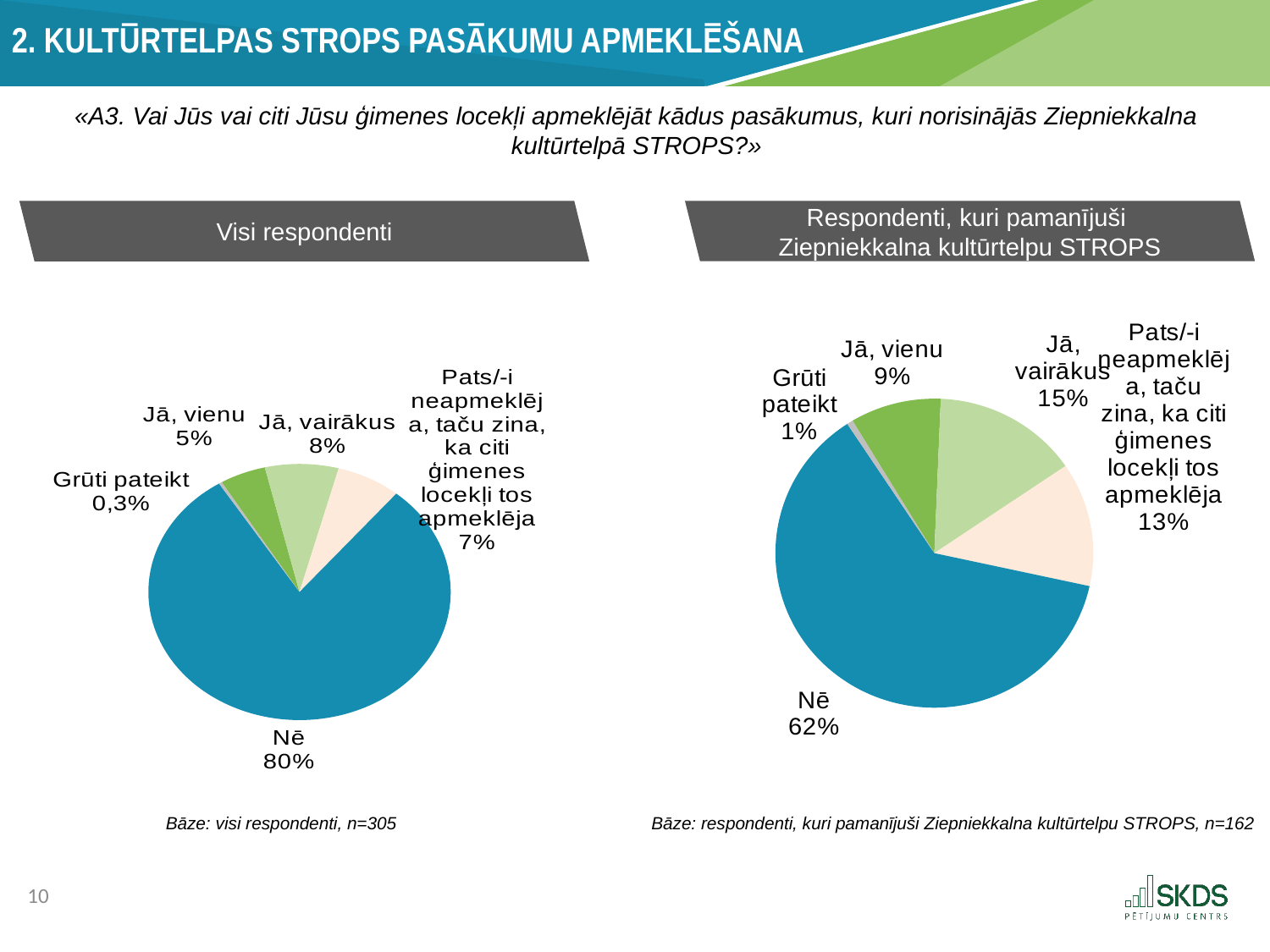
In the 'Visi respondenti' pie chart, what share of respondents answered 'Nē'? 80% In the 'Visi respondenti' pie chart, which category has the largest slice? Nē What is the difference between the 'Nē' share in the 'Visi respondenti' chart and the 'Nē' share in the 'Respondenti, kuri pamanījuši Ziepniekkalna kultūrtelpu STROPS' chart? 18 percentage points In the 'Visi respondenti' pie chart, what is the value for 'Jā, vairākus'? 8% What type of chart is used on the left side of the slide? Pie chart In the 'Respondenti, kuri pamanījuši Ziepniekkalna kultūrtelpu STROPS' pie chart, what is the value for 'Jā, vienu'? 9% In the 'Respondenti, kuri pamanījuši Ziepniekkalna kultūrtelpu STROPS' pie chart, what share answered 'Nē'? 62% How many slices does the 'Visi respondenti' pie chart have? 5 In the 'Respondenti, kuri pamanījuši Ziepniekkalna kultūrtelpu STROPS' pie chart, what is the value for 'Jā, vairākus'? 15% In the 'Visi respondenti' pie chart, what is the value for 'Grūti pateikt'? 0,3% In the 'Respondenti, kuri pamanījuši Ziepniekkalna kultūrtelpu STROPS' pie chart, which is larger: 'Jā, vairākus' or 'Jā, vienu'? Jā, vairākus In the 'Respondenti, kuri pamanījuši Ziepniekkalna kultūrtelpu STROPS' pie chart, which category has the smallest slice? Grūti pateikt